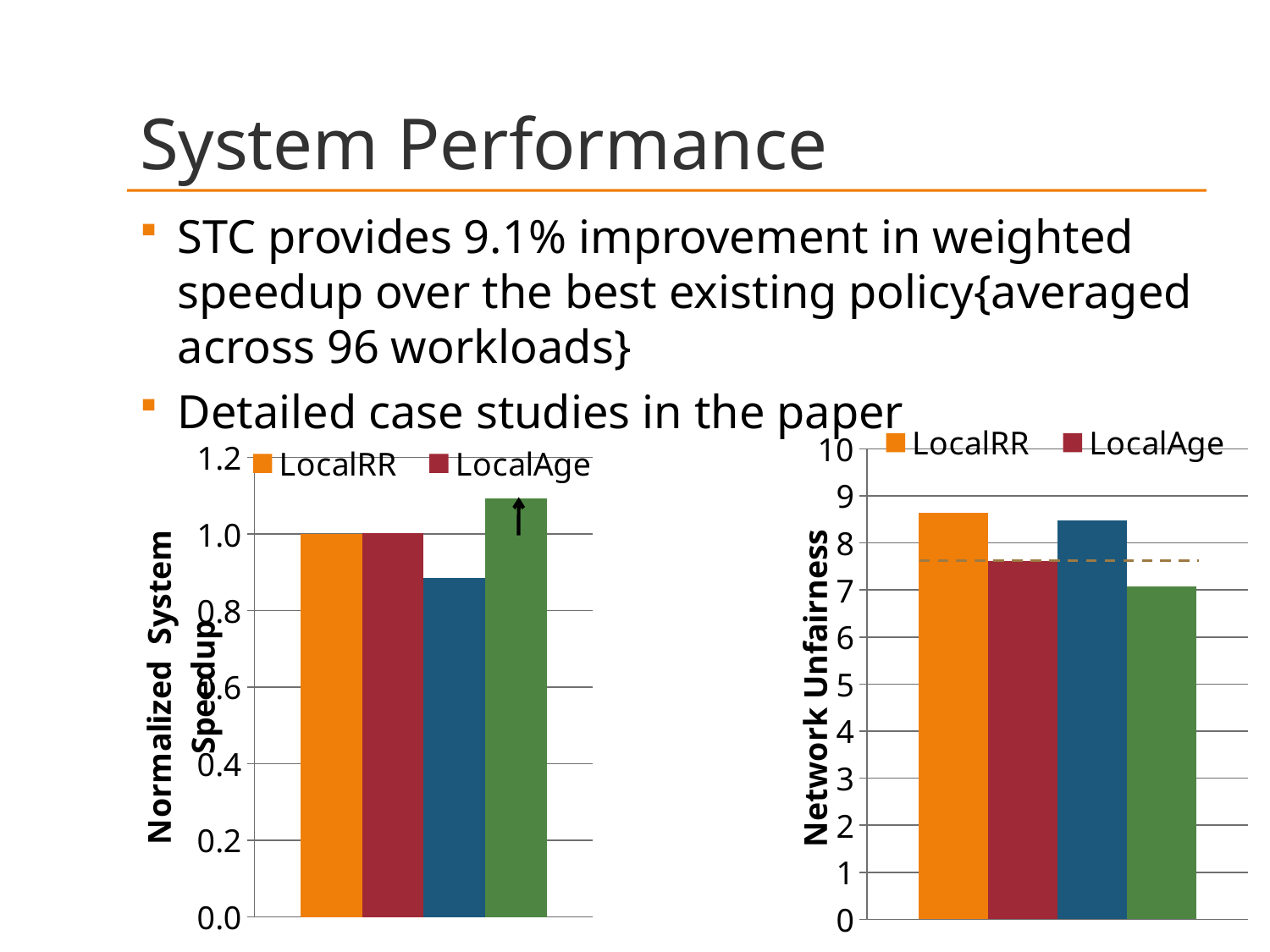
What kind of chart is the left chart (Normalized System Speedup)? bar chart What is the y-axis title of the right chart? Network Unfairness In the left chart (Normalized System Speedup), what is the value for LocalRR? 1.0 How many series does the legend of the right chart (Network Unfairness) list? 2 In the right chart (Network Unfairness), is the value for LocalAge greater or less than 8? less In the left chart (Normalized System Speedup), which bar is the highest? the green bar (fourth bar) In the left chart (Normalized System Speedup), is the value of the blue bar greater or less than 1.0? less In the right chart (Network Unfairness), which is larger, LocalRR or LocalAge? LocalRR How many bars are plotted in the left chart (Normalized System Speedup)? 4 In the right chart (Network Unfairness), which bar is the lowest? the green bar (fourth bar) In the right chart (Network Unfairness), is the value for LocalRR greater or less than 8? greater In the left chart (Normalized System Speedup), which bar is the lowest? the blue bar (third bar)